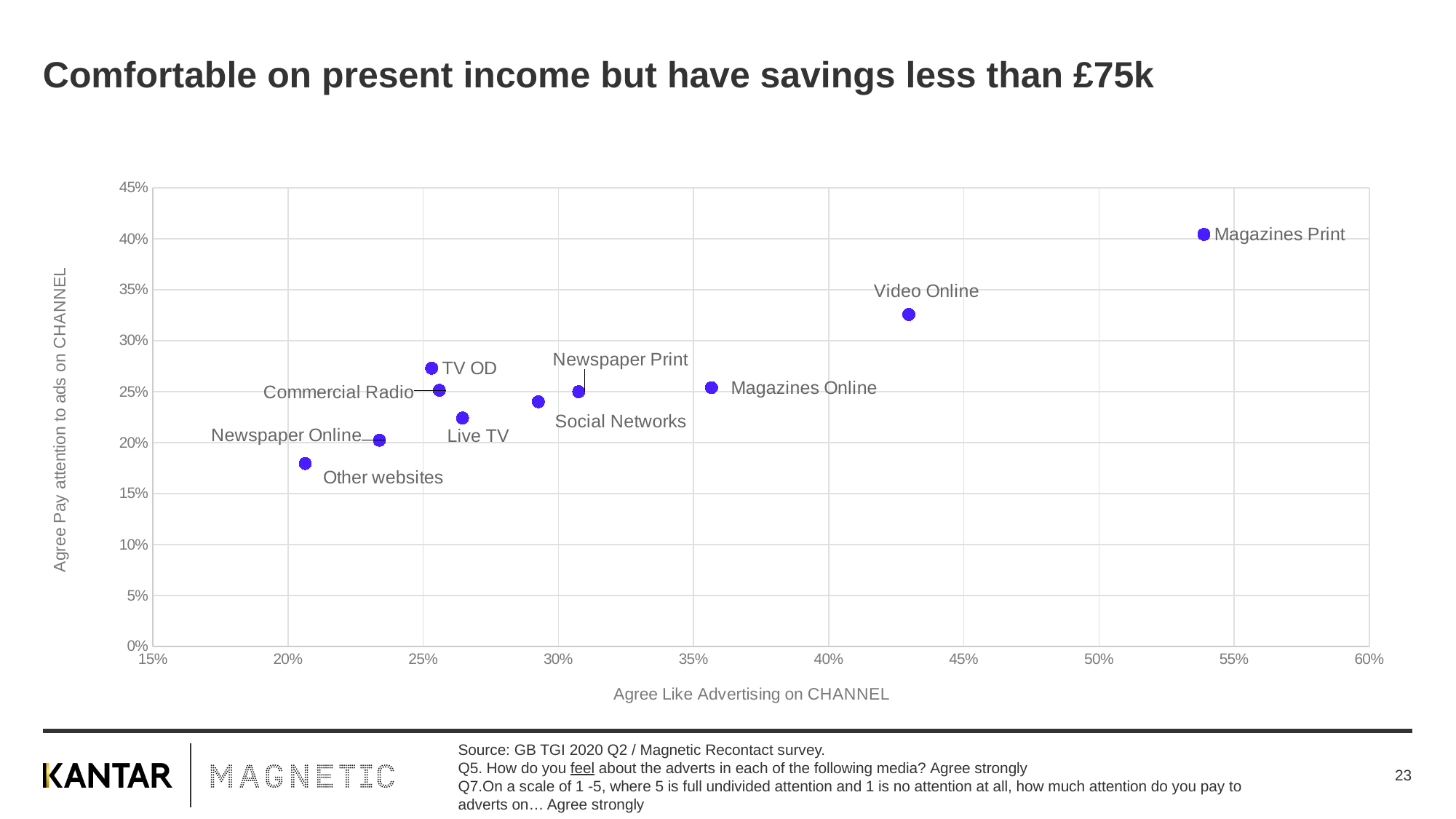
What kind of chart is shown on the slide? Scatter chart Is the Agree Pay attention to ads value for Video Online greater or less than 30%? greater Which channel has the lowest value for Agree Pay attention to ads on CHANNEL? Other websites Do the Agree Pay attention to ads values generally rise or fall as Agree Like Advertising increases along the x axis? Rise How many channels are plotted on the chart? 10 Is the Agree Pay attention to ads value for Other websites greater or less than 20%? less Which has a higher Agree Like Advertising value, Video Online or Magazines Online? Video Online Which channel has the lowest value for Agree Like Advertising on CHANNEL? Other websites Is the Agree Like Advertising value for Magazines Print greater or less than 50%? greater Which channel has the highest value for Agree Pay attention to ads on CHANNEL? Magazines Print Which has a higher Agree Pay attention to ads value, TV OD or Live TV? TV OD What is the title of the x axis? Agree Like Advertising on CHANNEL